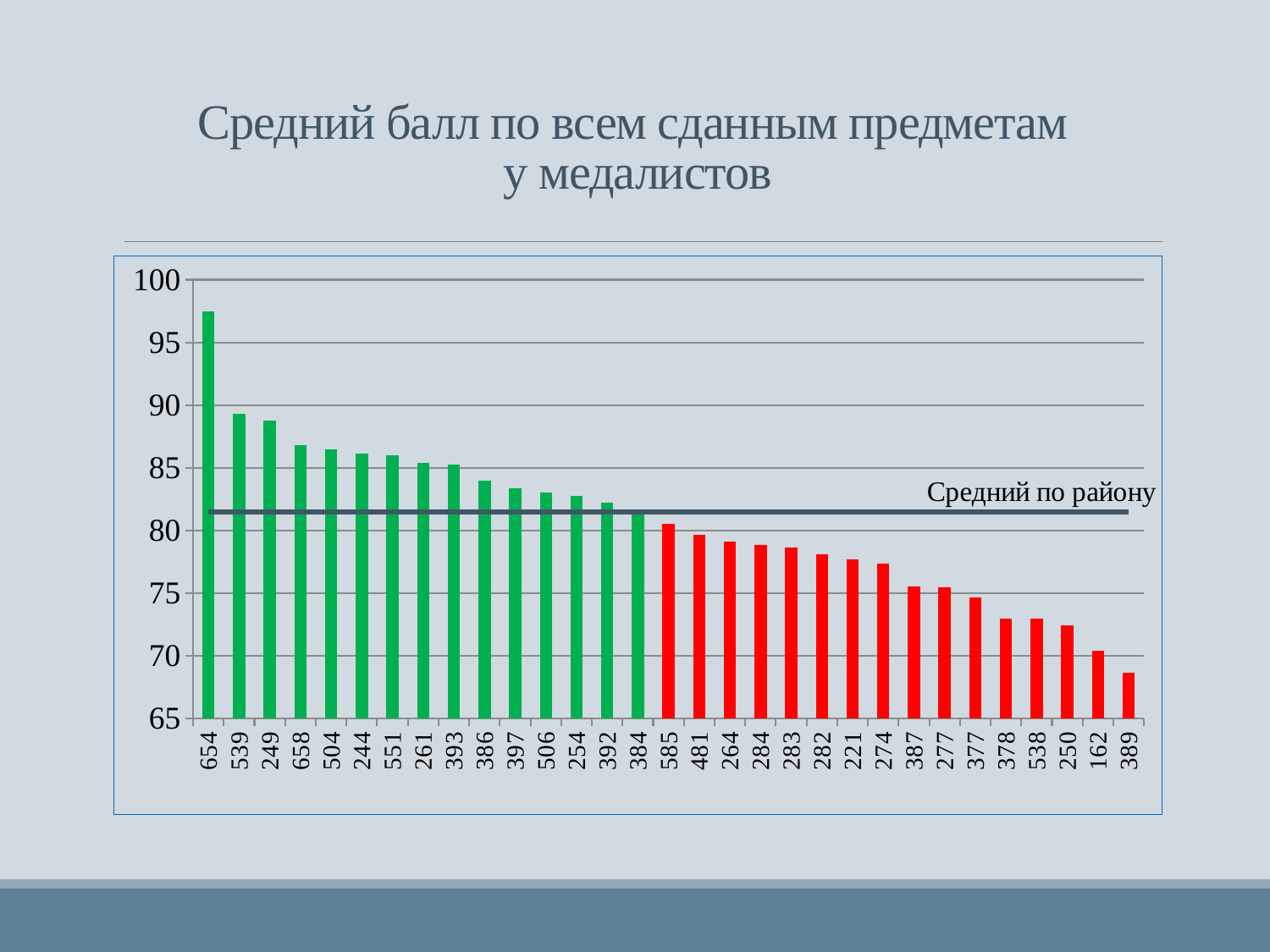
What is the label of the horizontal line drawn across the chart? Средний по району Is the value for 221 greater or less than 80? less How many categories (bars) are plotted on the chart? 31 Which category has the highest value? 654 Is the value for 389 greater or less than 70? less Which category has the lowest value? 389 What kind of chart is shown on the slide? bar chart Which has the larger value, 654 or 539? 654 Is the value for 386 greater or less than 85? less Do the bar values rise or fall from left to right along the x axis? fall